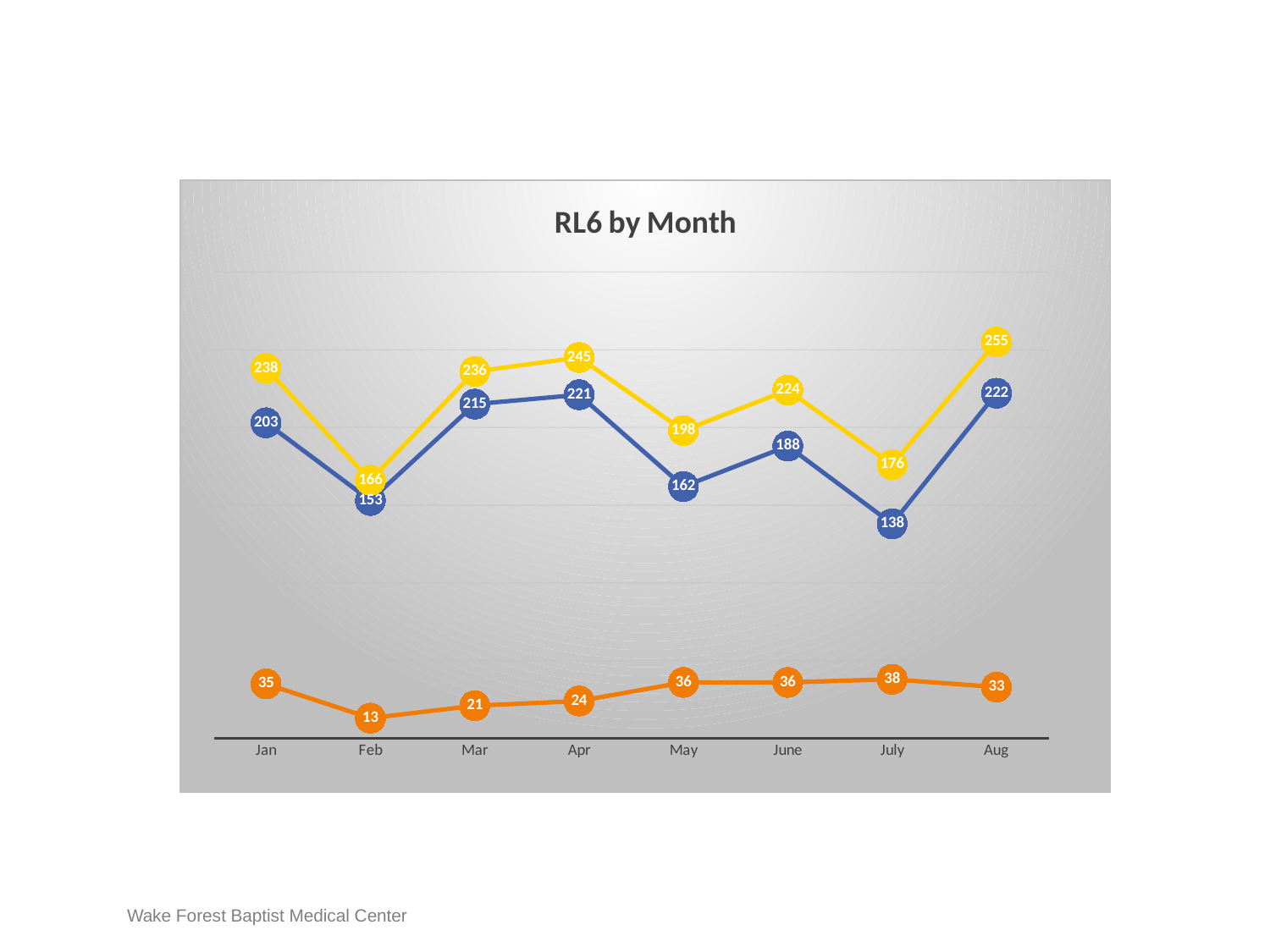
In which month does the yellow line reach its highest value? Aug In which month does the orange line reach its highest value? July What is the value of the blue line in July? 138 Which is larger, the blue line's value in Mar or its value in May? Mar What kind of chart is shown on the slide? line chart What is the difference between the yellow line and the blue line in Jan? 35 What is the title of the chart? RL6 by Month What is the value of the orange line in Feb? 13 How many lines are plotted on the chart? 3 What is the value of the yellow line in Apr? 245 How many months are plotted along the x axis? 8 In which month does the blue line reach its lowest value? July